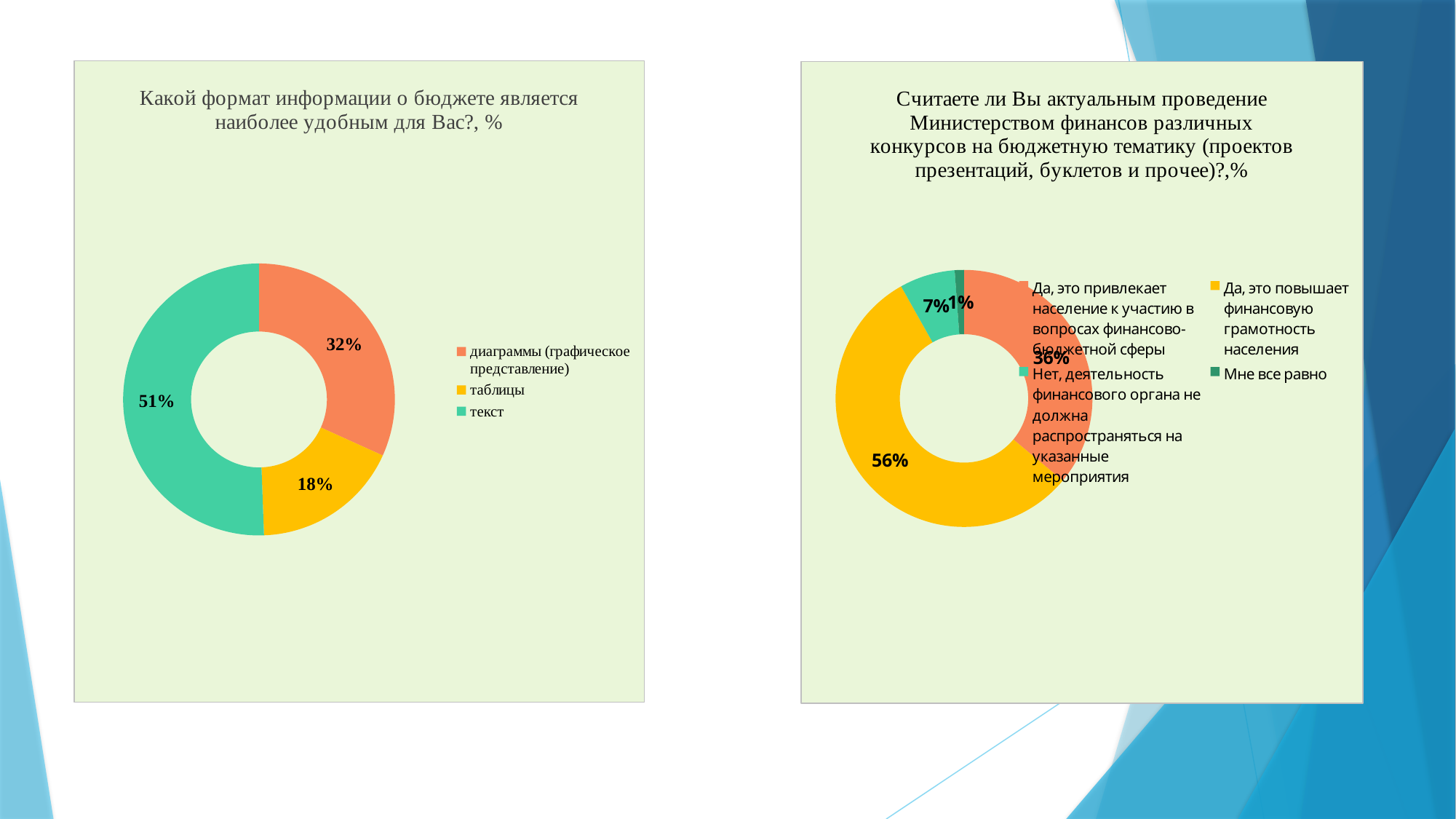
What type of chart is the left chart? doughnut chart In the left chart, what share of respondents chose 'текст'? 51% In the left chart, what share of respondents chose 'таблицы'? 18% In the left chart, which format has the largest share? текст In the right chart, which answer has the largest share? Да, это повышает финансовую грамотность населения In the right chart, what share of respondents answered 'Да, это повышает финансовую грамотность населения'? 56% How many categories does the legend of the left chart list? 3 In the left chart, which format has the smallest share? таблицы How many categories does the legend of the right chart list? 4 In the right chart, what share of respondents answered 'Мне все равно'? 1% In the left chart, what is the difference in percentage points between 'текст' and 'диаграммы (графическое представление)'? 19 In the right chart, which is larger: the share for 'Да, это привлекает население к участию в вопросах финансово-бюджетной сферы' or the share for 'Нет, деятельность финансового органа не должна распространяться на указанные мероприятия'? Да, это привлекает население к участию в вопросах финансово-бюджетной сферы